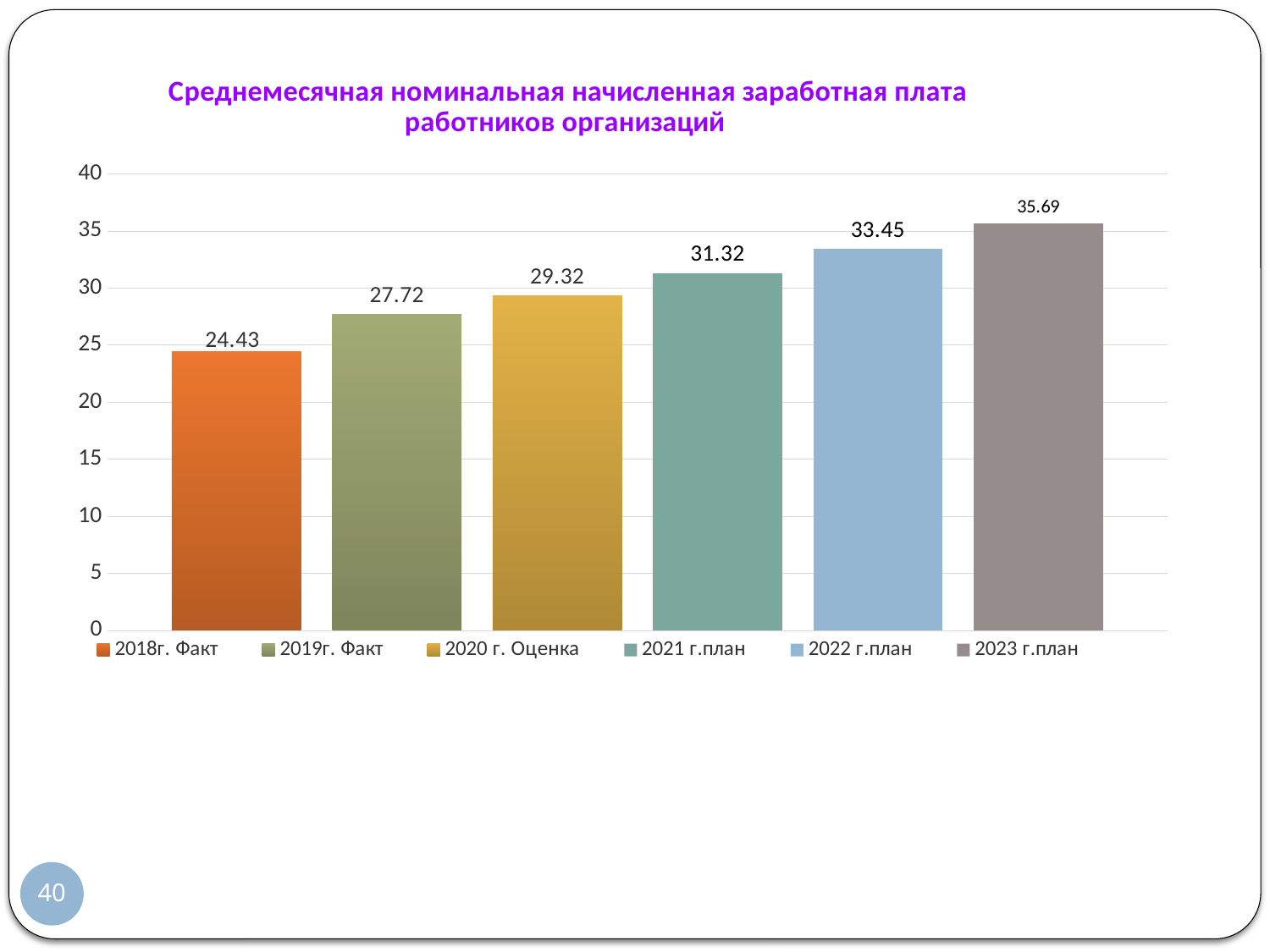
Is the value for 2022 г.план greater or less than 30? greater Which series has the highest value? 2023 г.план What is the difference between the values for 2021 г.план and 2019г. Факт? 3.6 Do the values rise or fall from 2018г. Факт to 2023 г.план? rise What is the value for 2022 г.план? 33.45 What is the value for 2020 г. Оценка? 29.32 What is the difference between the values for 2023 г.план and 2018г. Факт? 11.26 What is the value for 2018г. Факт? 24.43 Which is larger, the value for 2019г. Факт or the value for 2021 г.план? 2021 г.план What kind of chart is shown on the slide? bar chart Which series has the lowest value? 2018г. Факт How many series does the legend list? 6